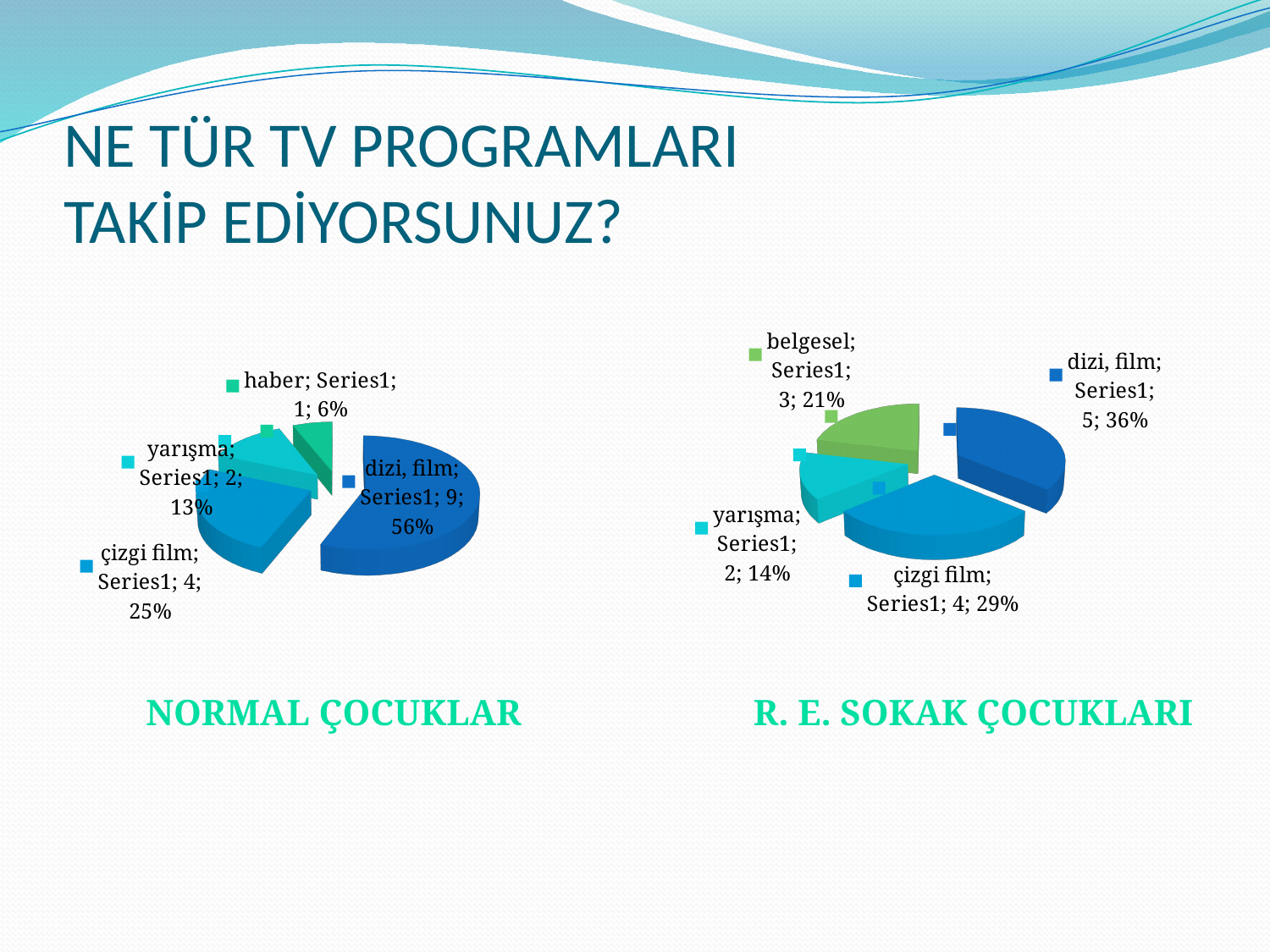
In the NORMAL ÇOCUKLAR pie chart, how many categories are shown? 4 In the NORMAL ÇOCUKLAR pie chart, which category has the smallest slice? haber In the NORMAL ÇOCUKLAR pie chart, which category has the largest slice? dizi, film What type of chart is used for the R. E. SOKAK ÇOCUKLARI data? Pie chart In the R. E. SOKAK ÇOCUKLARI pie chart, what value is shown for belgesel? 3 Which category appears in the R. E. SOKAK ÇOCUKLARI pie chart but not in the NORMAL ÇOCUKLAR pie chart? belgesel In the R. E. SOKAK ÇOCUKLARI pie chart, which is larger, çizgi film or belgesel? çizgi film In the NORMAL ÇOCUKLAR pie chart, what is the difference between the values for dizi, film and çizgi film? 5 In the R. E. SOKAK ÇOCUKLARI pie chart, what percentage share does dizi, film have? 36% In the NORMAL ÇOCUKLAR pie chart, what percentage share does çizgi film have? 25% In the R. E. SOKAK ÇOCUKLARI pie chart, which category has the smallest slice? yarışma In the NORMAL ÇOCUKLAR pie chart, what value is shown for dizi, film? 9